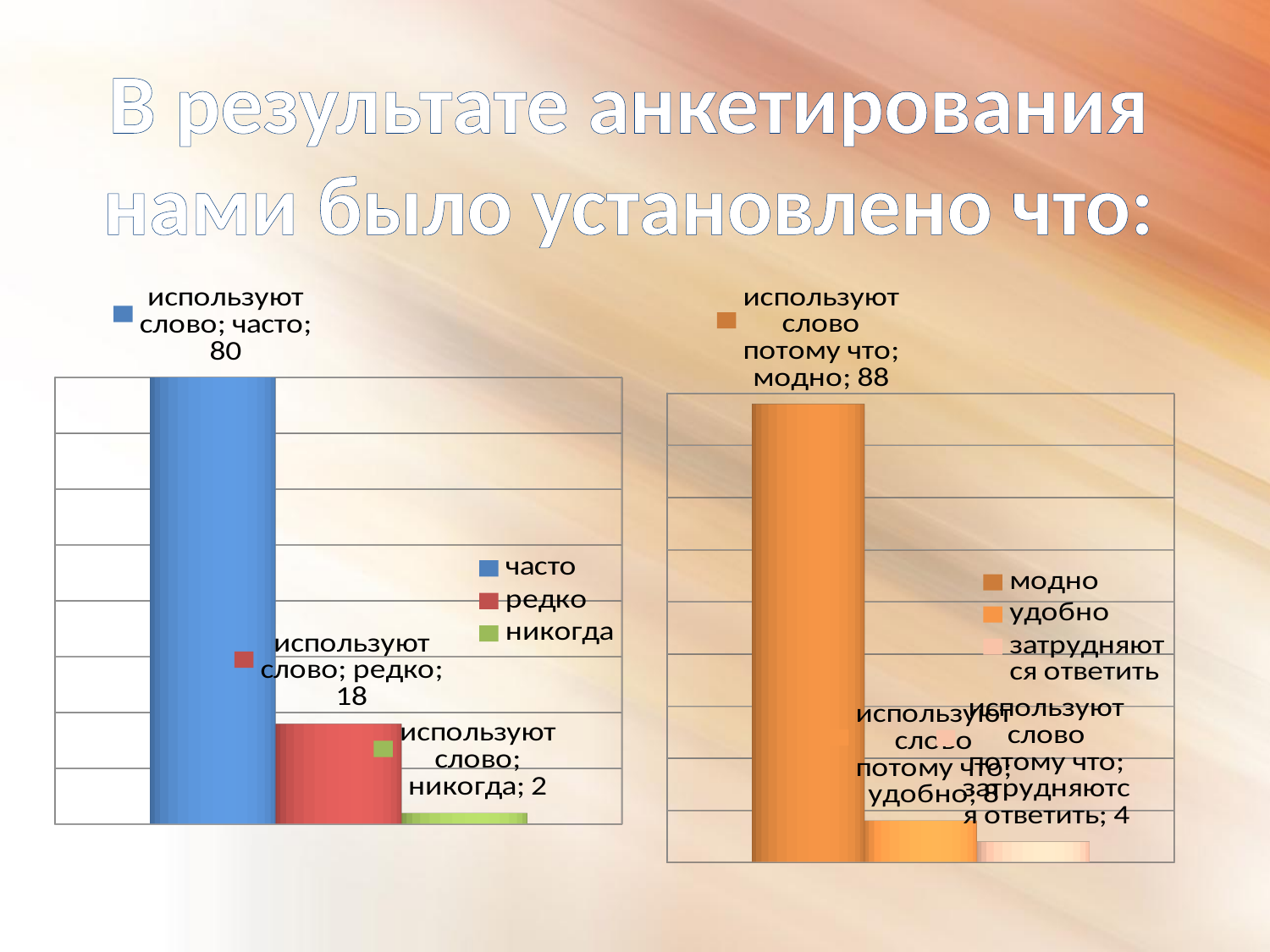
On the left chart, what is the difference between the values for 'часто' and 'редко'? 62 What type of chart is the right chart? bar chart On the right chart, which is larger: the value for 'удобно' or the value for 'затрудняются ответить'? удобно On the left chart, what is the value for 'никогда'? 2 On the left chart, how many entries does the legend list? 3 On the right chart, what is the value for 'затрудняются ответить'? 4 On the left chart, what is the value for 'редко'? 18 On the right chart, which category has the highest value? модно On the left chart, which category has the highest value? часто On the left chart, what is the value for 'часто'? 80 On the left chart, which category has the lowest value? никогда On the right chart, what is the value for 'модно'? 88